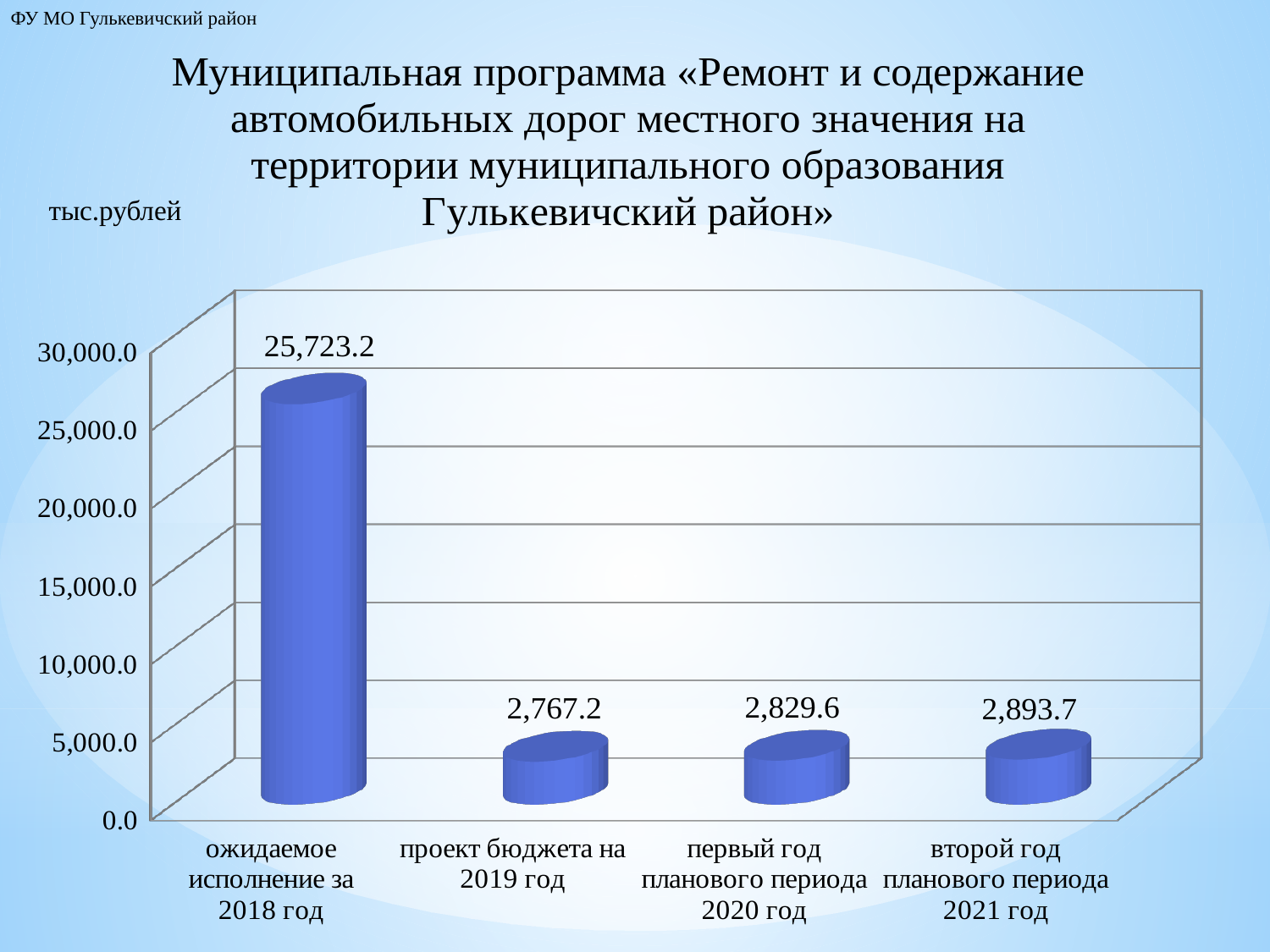
Which category has the highest value? ожидаемое исполнение за 2018 год What is the value for 'проект бюджета на 2019 год'? 2,767.2 What is the value for 'первый год планового периода 2020 год'? 2,829.6 How many categories are shown on the chart? 4 Which category has the lowest value? проект бюджета на 2019 год What unit of measurement is indicated for the chart values? тыс.рублей What is the value for 'второй год планового периода 2021 год'? 2,893.7 What kind of chart is shown on the slide? bar chart What is the value for 'ожидаемое исполнение за 2018 год'? 25,723.2 What is the difference between the value for 2018 (ожидаемое исполнение) and the value for 2019 (проект бюджета)? 22,956.0 Which is larger: the value for 2020 or the value for 2021? 2021 What is the difference between the values for 2021 and 2020 (плановый период)? 64.1